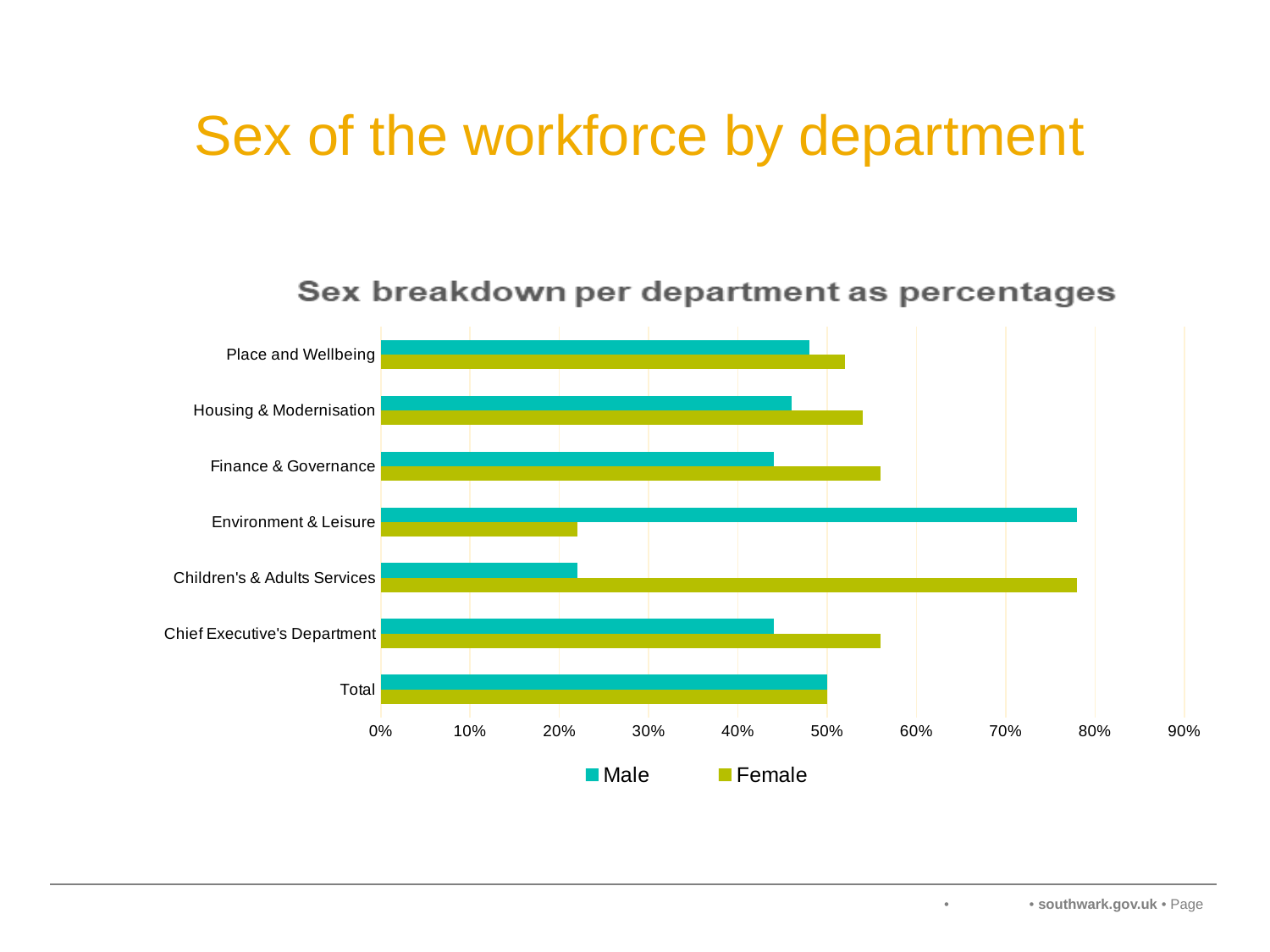
Is the Male value for Environment & Leisure greater or less than 70%? greater How many series does the legend list? 2 Is the Male value for Children's & Adults Services greater or less than 30%? less Which category has the highest Female percentage? Children's & Adults Services What kind of chart is shown on the slide? Bar chart What is the title of the chart? Sex breakdown per department as percentages Which category has the lowest Female percentage? Environment & Leisure How many categories are plotted on the y axis of the chart? 7 Which category has the lowest Male percentage? Children's & Adults Services For Finance & Governance, which is larger, the Male or the Female percentage? Female Is the Female value for Environment & Leisure greater or less than 30%? less Which category has the highest Male percentage? Environment & Leisure